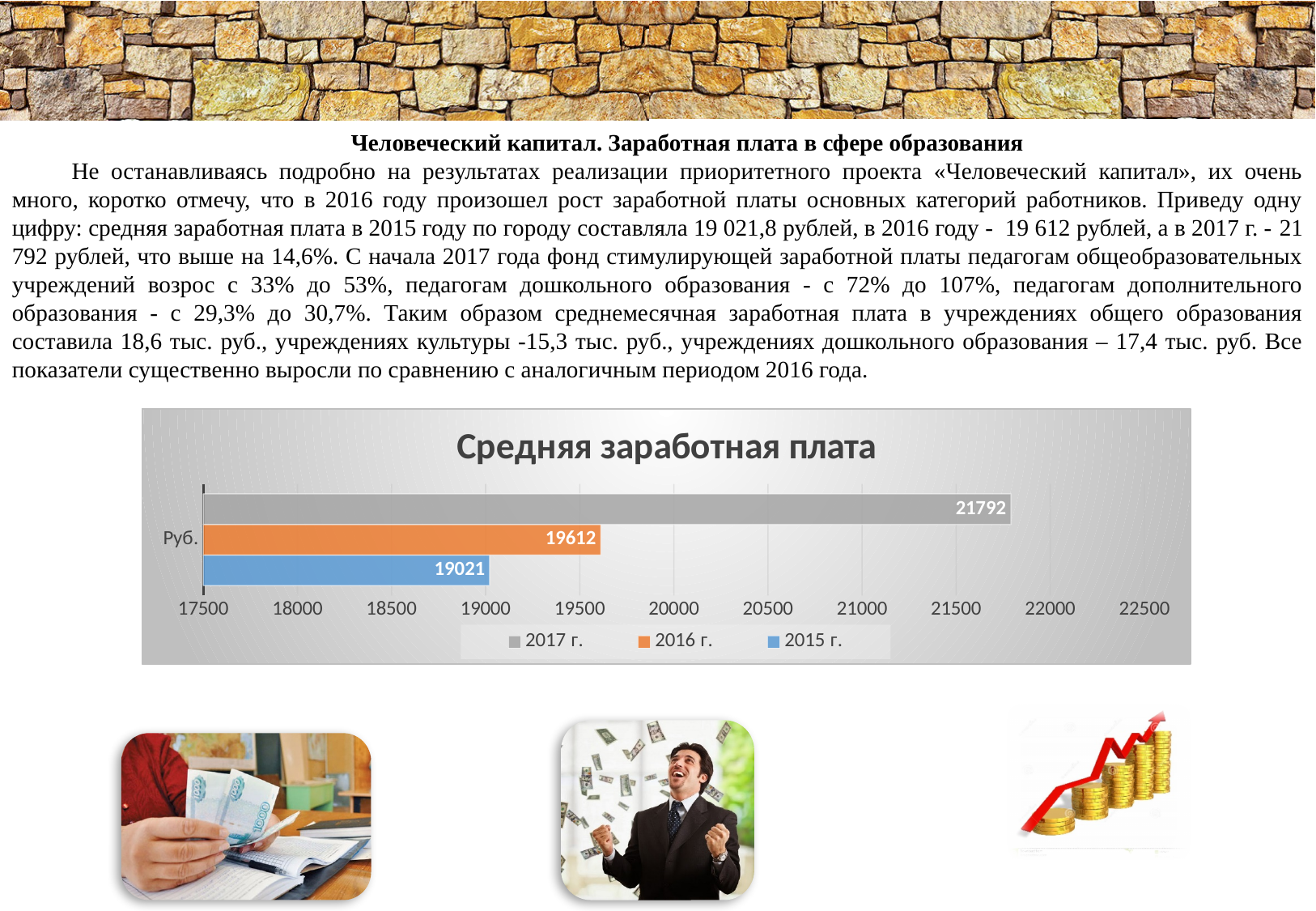
Which year has the highest average salary in the chart? 2017 г. What kind of chart is shown on the slide? Bar chart What is the value for 2015 г. in the chart "Средняя заработная плата"? 19021 How many series does the legend of the chart list? 3 Which year has the lowest average salary in the chart? 2015 г. What is the value for 2017 г. in the chart "Средняя заработная плата"? 21792 Is the value for 2017 г. greater or less than 21500? greater What is the difference between the 2016 г. and 2015 г. values in the chart? 591 What is the value for 2016 г. in the chart "Средняя заработная плата"? 19612 What is the title of the chart on the slide? Средняя заработная плата What is the difference between the 2017 г. and 2016 г. values in the chart? 2180 Which is larger in the chart, the value for 2016 г. or the value for 2015 г.? 2016 г.